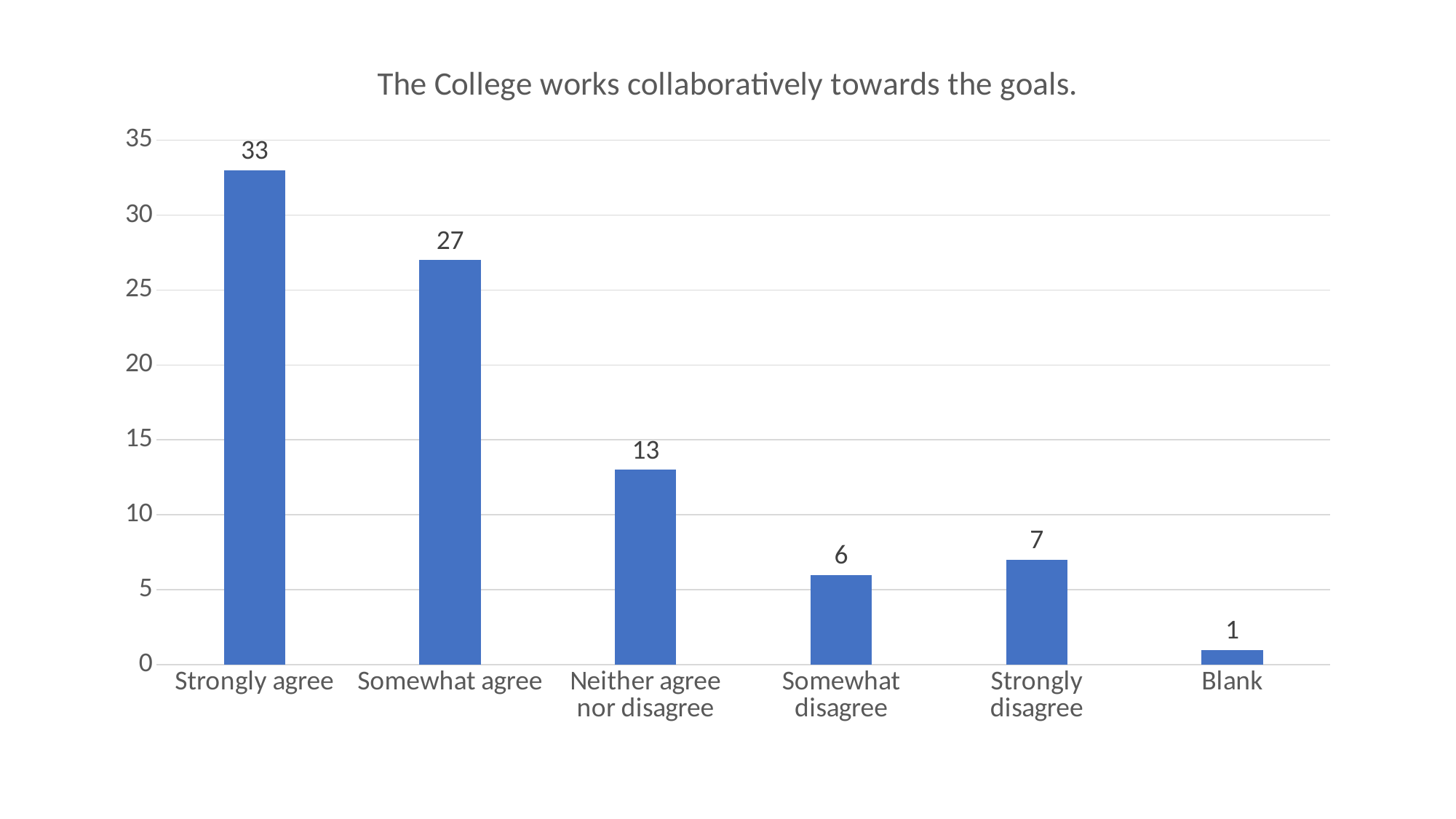
What is the value for Strongly agree? 33 Which category has the highest value? Strongly agree What is the difference between the values for Strongly agree and Somewhat agree? 6 What is the value for Neither agree nor disagree? 13 What is the value for Strongly disagree? 7 Is the value for Somewhat agree greater or less than 25? greater Which category has the lowest value? Blank How many categories are shown on the x axis? 6 What is the difference between the values for Neither agree nor disagree and Somewhat disagree? 7 Which is larger, the value for Somewhat disagree or the value for Strongly disagree? Strongly disagree What is the title of the chart? The College works collaboratively towards the goals. What kind of chart is shown on the slide? bar chart